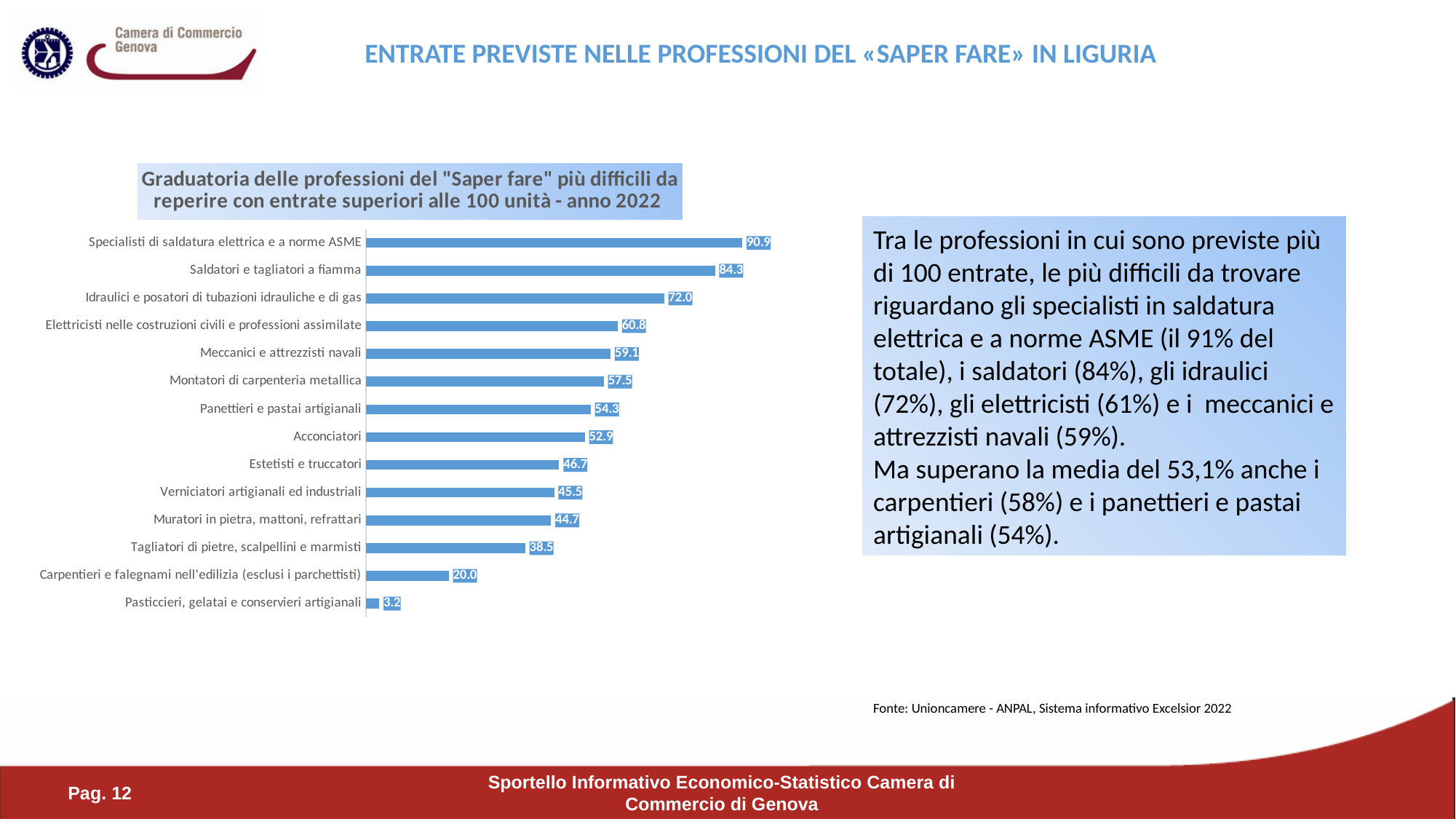
What is the value for Acconciatori? 52.9 Which profession has the highest value in the chart? Specialisti di saldatura elettrica e a norme ASME What is the value for Meccanici e attrezzisti navali? 59.1 What is the difference between the values for Carpentieri e falegnami nell'edilizia (esclusi i parchettisti) and Pasticcieri, gelatai e conservieri artigianali? 16.8 How many professions are shown in the chart? 14 What is the value for Idraulici e posatori di tubazioni idrauliche e di gas? 72.0 What is the value for Tagliatori di pietre, scalpellini e marmisti? 38.5 What kind of chart is shown on the slide? Bar chart What is the difference between the values for Saldatori e tagliatori a fiamma and Idraulici e posatori di tubazioni idrauliche e di gas? 12.3 Which has a larger value, Estetisti e truccatori or Muratori in pietra, mattoni, refrattari? Estetisti e truccatori Which profession has the lowest value in the chart? Pasticcieri, gelatai e conservieri artigianali What year does the chart title refer to? 2022